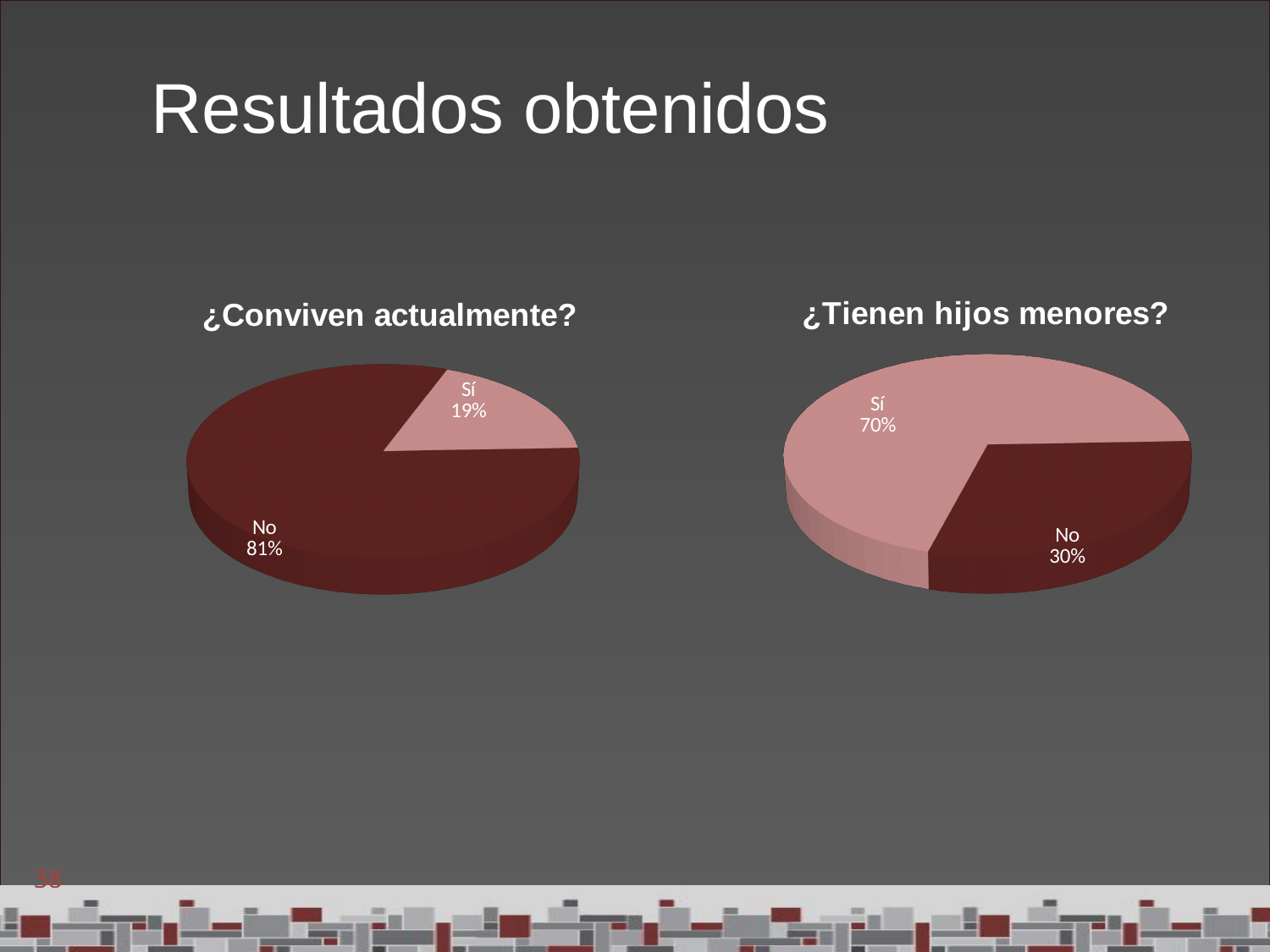
In the '¿Tienen hijos menores?' chart, what is the difference in percentage points between 'Sí' and 'No'? 40 In the '¿Conviven actualmente?' chart, what percentage answered 'Sí'? 19% How many charts are shown on the slide? 2 In the '¿Conviven actualmente?' chart, which answer has the largest share? No In the '¿Conviven actualmente?' chart, what percentage answered 'No'? 81% How many slices does the '¿Tienen hijos menores?' chart have? 2 In the '¿Tienen hijos menores?' chart, what percentage answered 'Sí'? 70% In the '¿Tienen hijos menores?' chart, which is larger, 'Sí' or 'No'? Sí What type of chart is used for '¿Conviven actualmente?'? Pie chart In the '¿Tienen hijos menores?' chart, which answer has the smallest share? No In the '¿Conviven actualmente?' chart, what is the difference in percentage points between 'No' and 'Sí'? 62 In the '¿Tienen hijos menores?' chart, what percentage answered 'No'? 30%